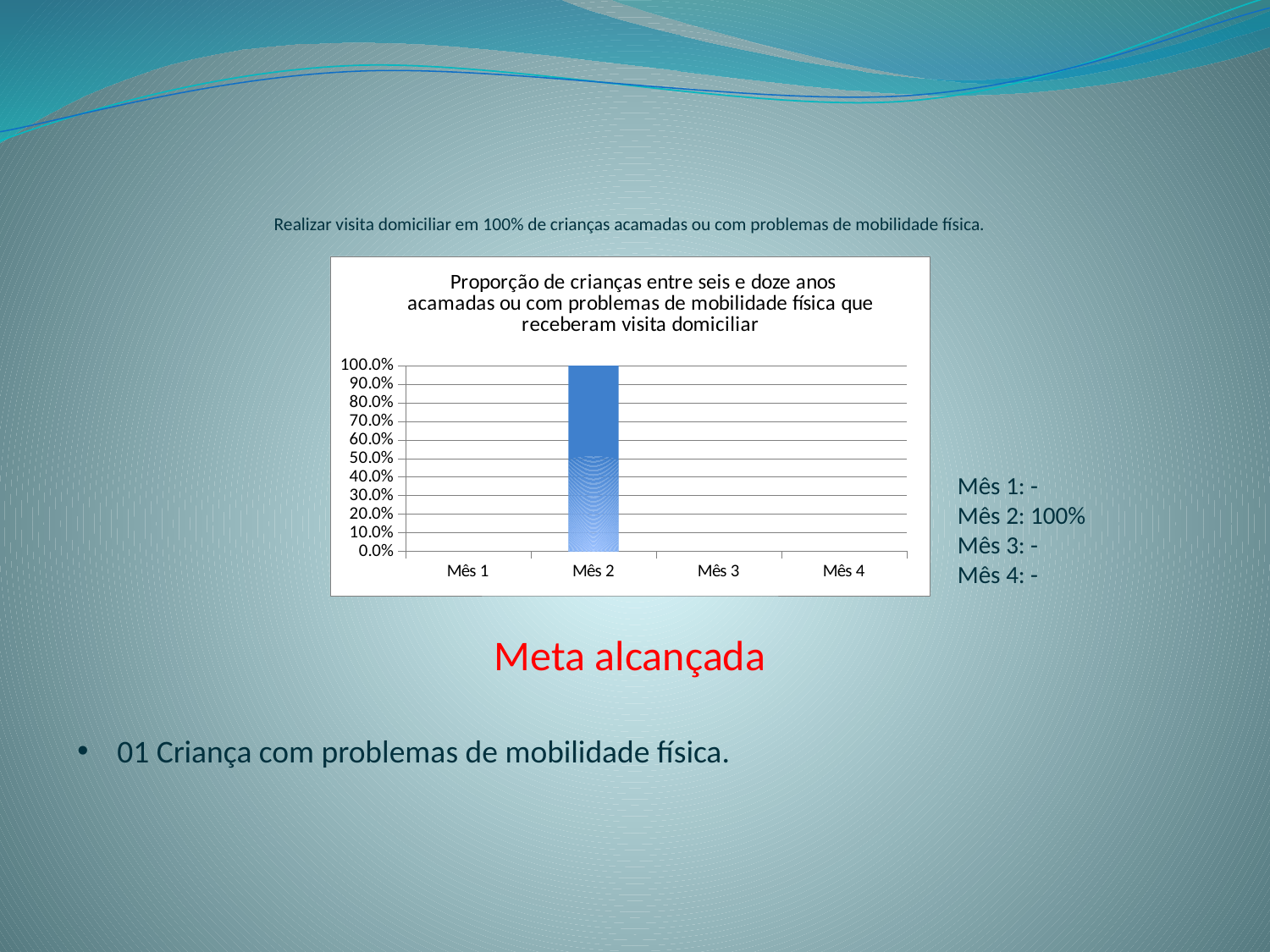
According to the text beside the chart, what value is given for Mês 3? - Which month has the highest value in the chart? Mês 2 What is the highest tick value shown on the y axis of the chart? 100.0% What kind of chart is shown on the slide? Bar chart How many categories are shown on the x axis of the chart? 4 Which months in the chart show no bar at all? Mês 1, Mês 3, Mês 4 How many of the months in the chart have a visible bar? 1 What is the value for Mês 2 in the chart? 100.0% Is the value for Mês 2 greater or less than 90.0%? greater What is the title of the chart? Proporção de crianças entre seis e doze anos acamadas ou com problemas de mobilidade física que receberam visita domiciliar Which is larger, the value for Mês 2 or the value for Mês 3? Mês 2 Is the value for Mês 2 greater or less than 50.0%? greater